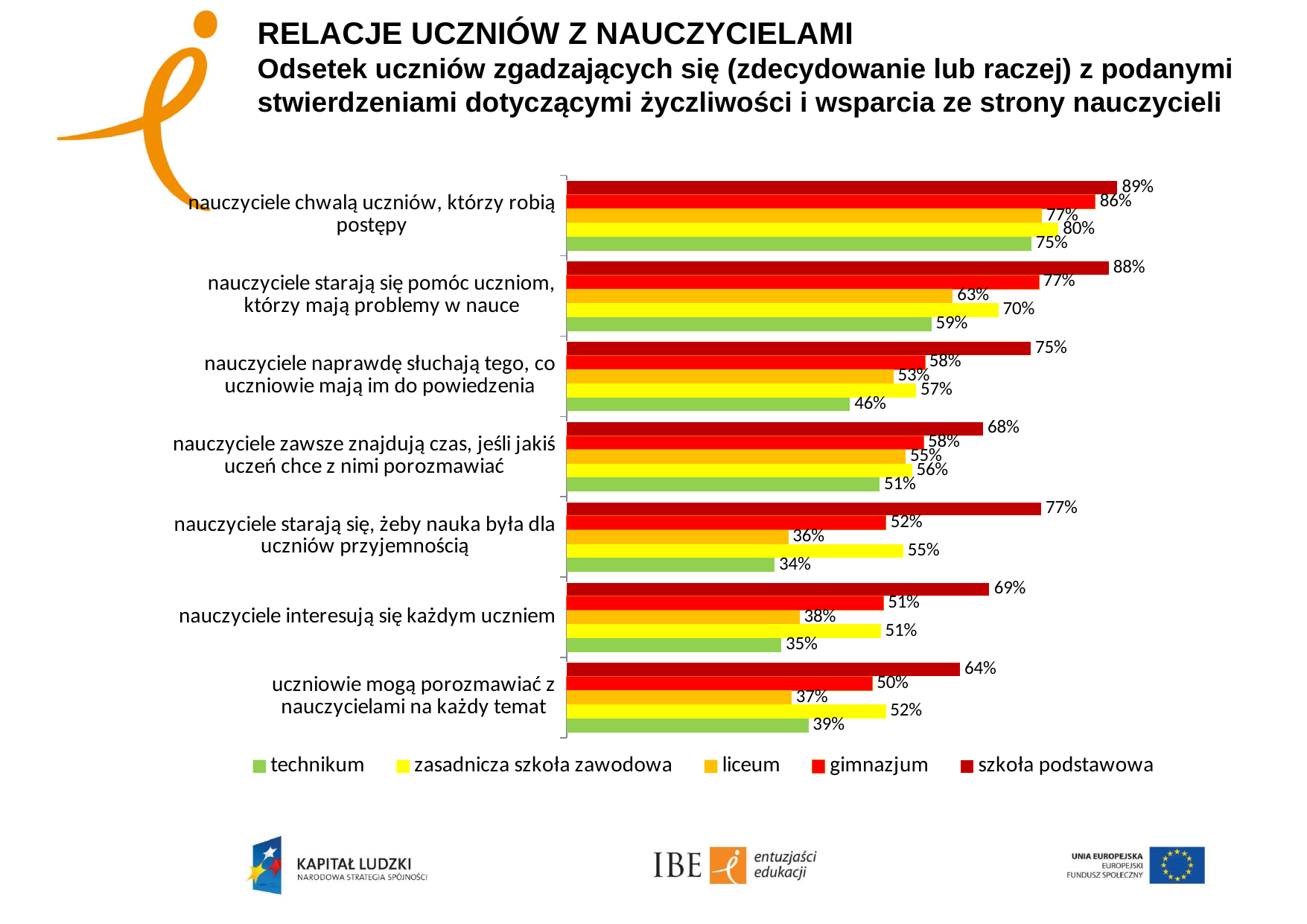
How many series does the legend list? 5 What kind of chart is shown on the slide? bar chart Which school type has the highest value for "nauczyciele starają się pomóc uczniom, którzy mają problemy w nauce"? szkoła podstawowa What is the value for liceum for the statement "nauczyciele starają się, żeby nauka była dla uczniów przyjemnością"? 36% How many statements (categories) are shown in the chart? 7 What is the value for zasadnicza szkoła zawodowa for the statement "uczniowie mogą porozmawiać z nauczycielami na każdy temat"? 52% What is the difference between the szkoła podstawowa and technikum values for "nauczyciele starają się, żeby nauka była dla uczniów przyjemnością"? 43 percentage points Which school type has the lowest value for "nauczyciele interesują się każdym uczniem"? technikum For "nauczyciele zawsze znajdują czas, jeśli jakiś uczeń chce z nimi porozmawiać", which is larger: the gimnazjum value or the technikum value? gimnazjum Which colour represents gimnazjum in the chart? red What percentage of szkoła podstawowa students agree that "nauczyciele chwalą uczniów, którzy robią postępy"? 89% What is the value for technikum for the statement "nauczyciele naprawdę słuchają tego, co uczniowie mają im do powiedzenia"? 46%